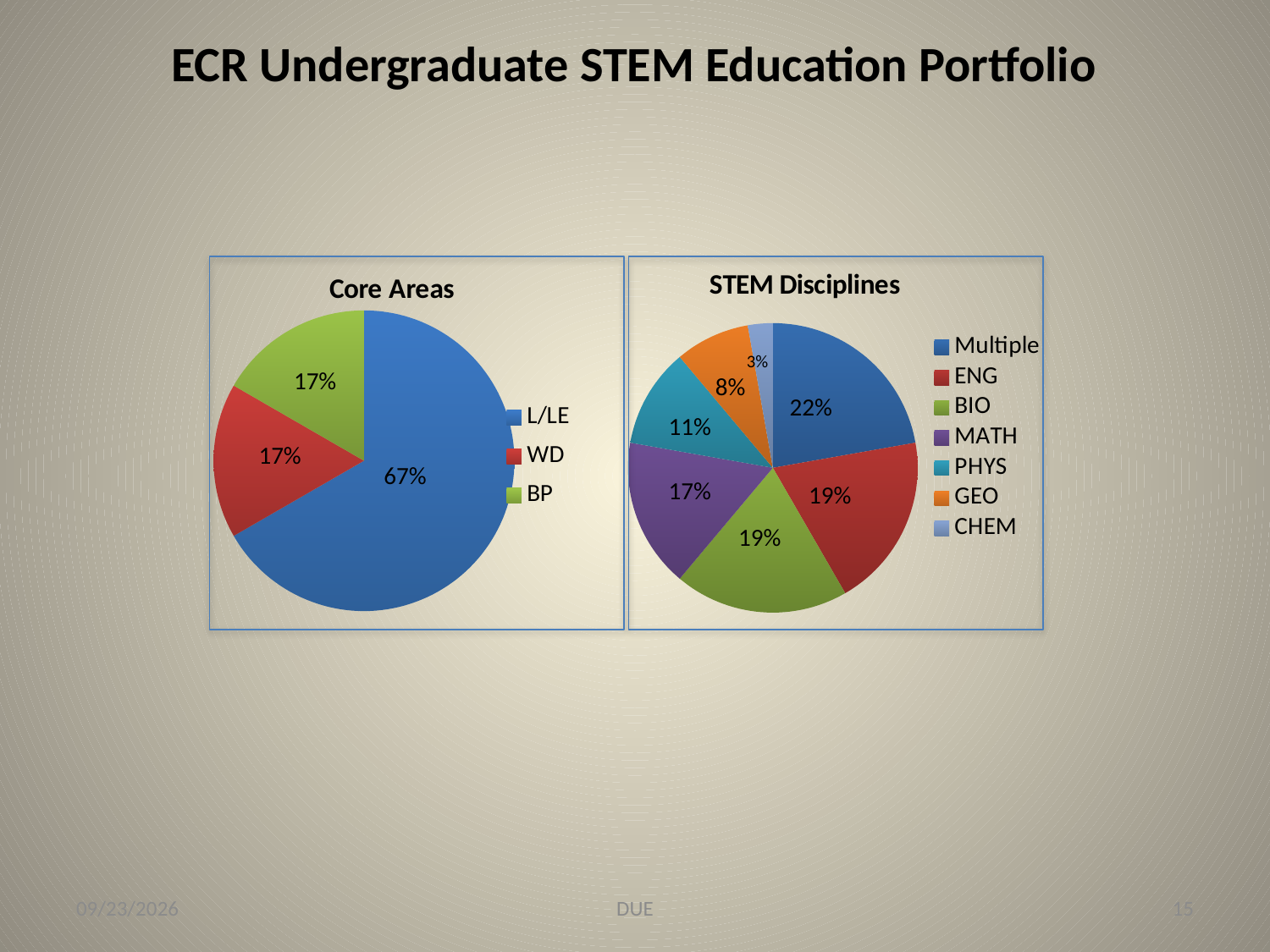
In the STEM Disciplines chart, what is the difference in percentage points between MATH and GEO? 9 How many entries does the legend of the STEM Disciplines chart list? 7 In the STEM Disciplines chart, what share of the pie does Multiple have? 22% In the Core Areas chart, what share of the pie does L/LE have? 67% In the Core Areas chart, what share of the pie does WD have? 17% In the STEM Disciplines chart, which is larger, the PHYS slice or the GEO slice? PHYS In the STEM Disciplines chart, which discipline has the smallest slice? CHEM What kind of chart is the Core Areas chart? Pie chart In the Core Areas chart, which category has the largest slice? L/LE In the STEM Disciplines chart, which discipline has the largest slice? Multiple In the Core Areas chart, how many slices does the pie have? 3